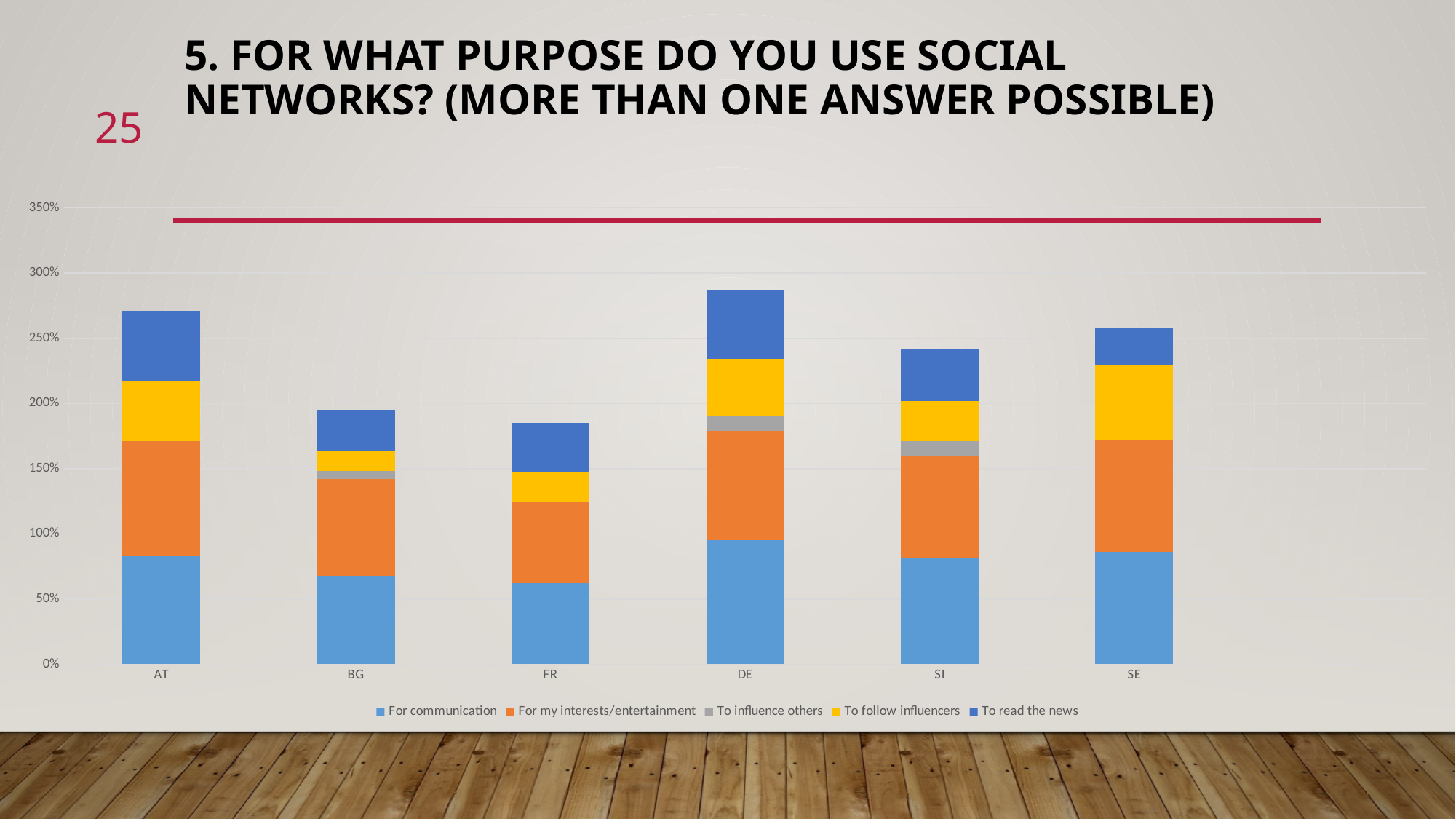
How many series does the chart legend list? 5 Which country has the tallest stacked bar overall? DE Is the total stacked value for DE greater or less than 250%? greater Which country has the shortest stacked bar overall? FR Which has the larger total stacked bar, DE or BG? DE How many countries are shown on the x axis of the chart? 6 Is the total stacked value for AT greater or less than 250%? greater Is the 'For communication' value for DE greater or less than 50%? greater Which series is shown in orange in the chart legend? For my interests/entertainment What is the title of the chart on the slide? 5. FOR WHAT PURPOSE DO YOU USE SOCIAL NETWORKS? (MORE THAN ONE ANSWER POSSIBLE) What kind of chart is shown on the slide? Stacked bar chart